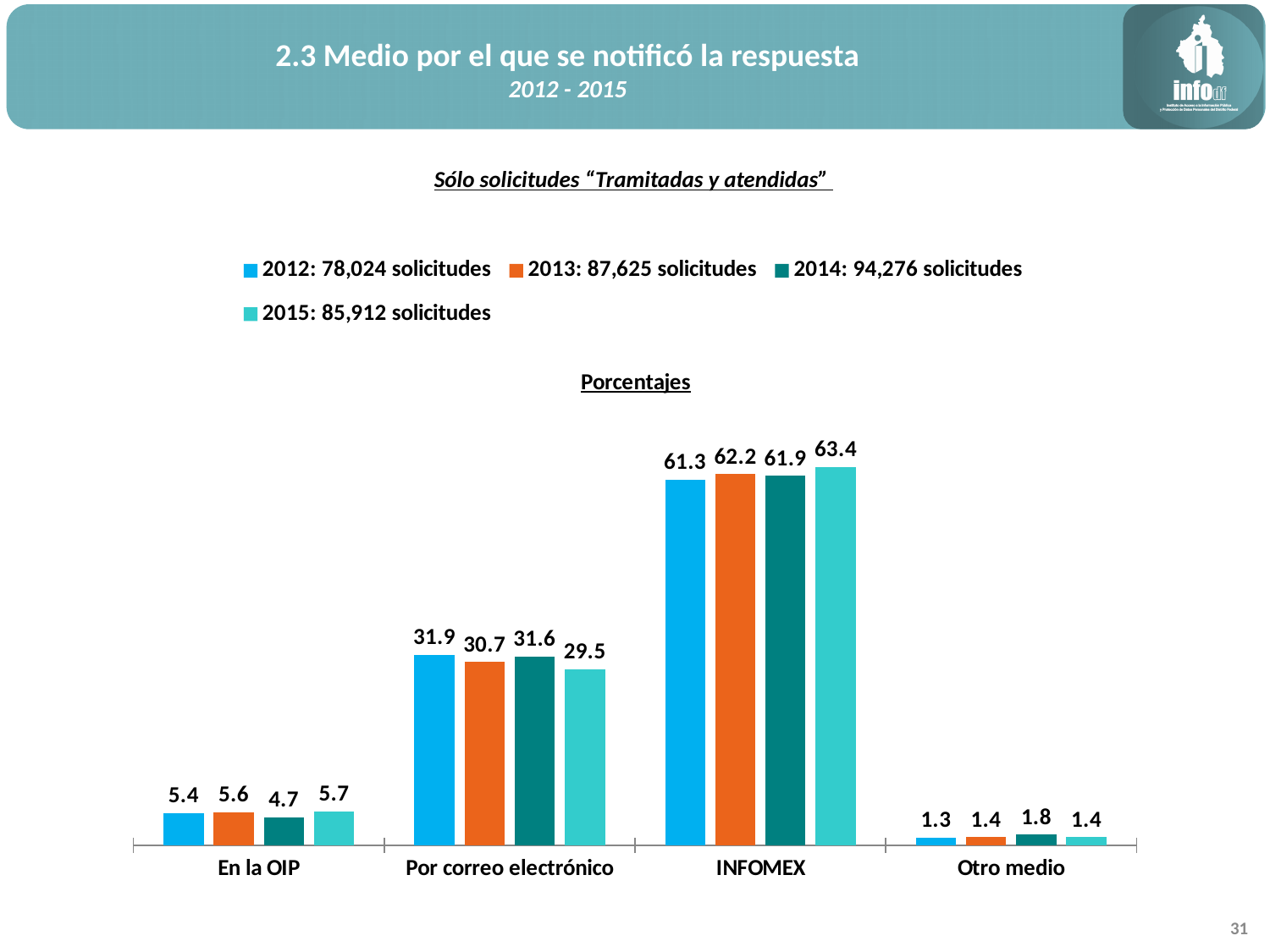
What kind of chart is shown on the slide? bar chart Which is larger for Por correo electrónico: the 2012 value or the 2015 value? 2012 According to the legend, how many solicitudes were there in 2014? 94,276 What is the value for En la OIP in the 2014 series? 4.7 What is the value for Otro medio in the 2013 series? 1.4 Which category has the highest value in the 2013 series? INFOMEX Which category has the lowest value in the 2012 series? Otro medio What is the value for INFOMEX in the 2015 series? 63.4 How many categories are shown on the x axis? 4 What is the difference between the 2015 and 2012 values for INFOMEX? 2.1 How many series does the legend list? 4 What is the value for Por correo electrónico in the 2012 series? 31.9